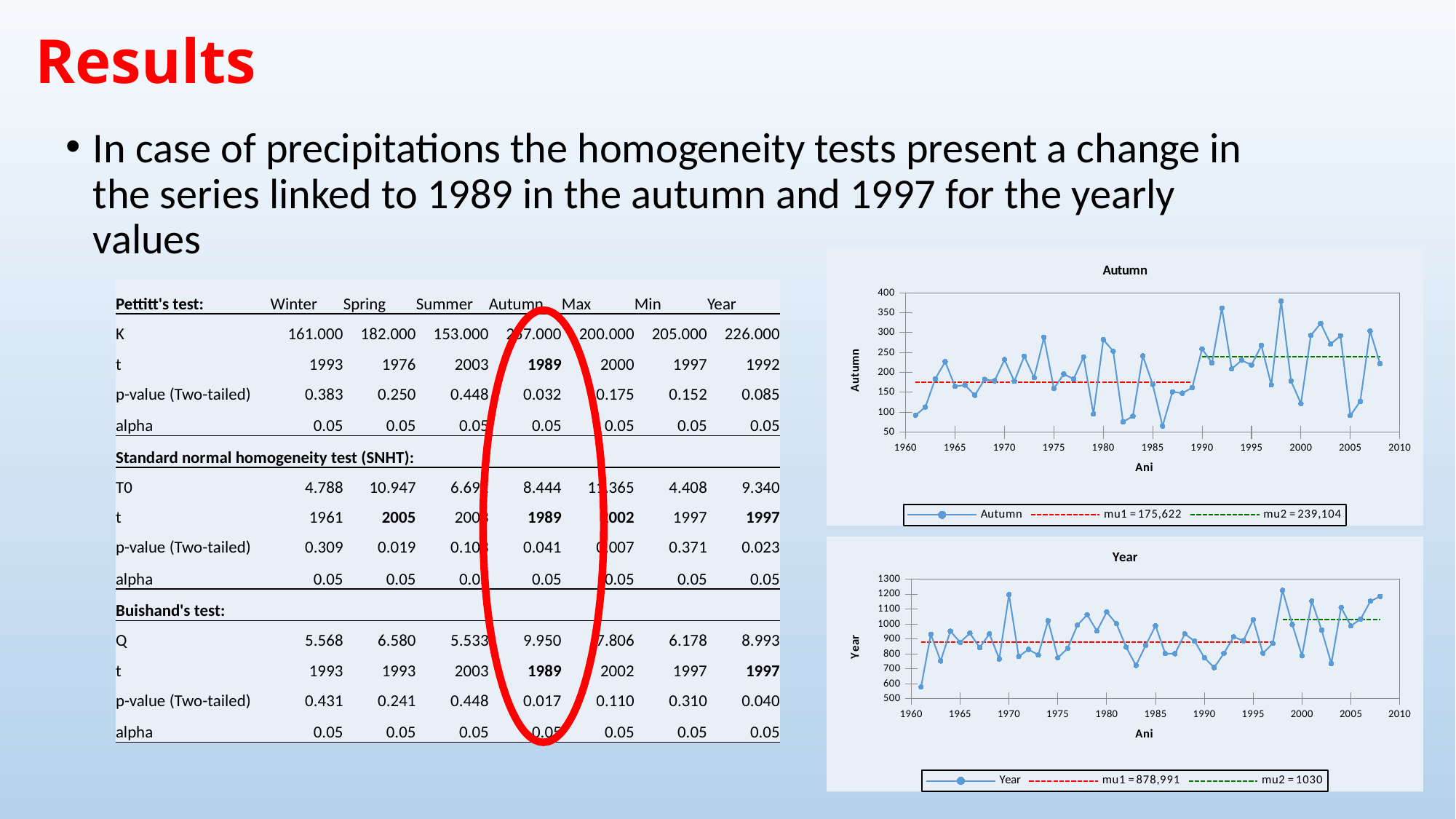
In the Autumn chart, what is the value of mu1 shown in the legend? 175,622 What is the label of the x axis on the Year chart? Ani What kind of chart is the Autumn chart? line chart In the Autumn chart, which is larger, mu1 or mu2? mu2 In the Year chart, what is the value of mu2 shown in the legend? 1030 In the Year chart, what is the value of mu1 shown in the legend? 878,991 In the Autumn chart, what is the value of mu2 shown in the legend? 239,104 In the Year chart, is the value for 1970 greater or less than 1100? greater In the Autumn chart, which year has the highest autumn value? 1998 In the Year chart, which year has the lowest value? 1961 How many series does the legend of the Year chart list? 3 In the Autumn chart, is the value for 1998 greater or less than 350? greater